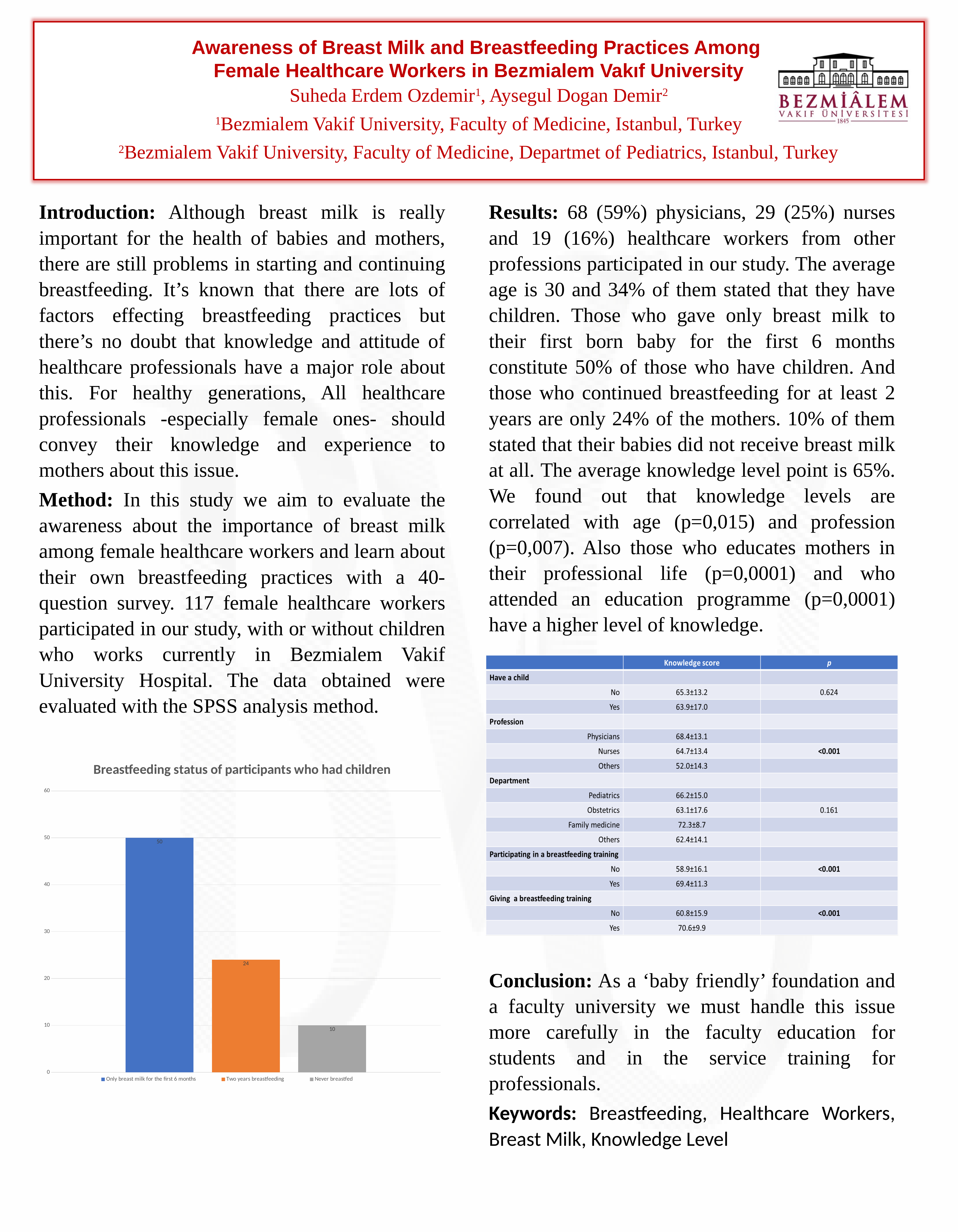
Which category has the highest value in the chart? Only breast milk for the first 6 months What is the value for 'Never breastfed' in the chart? 10 What kind of chart is shown on the slide? bar chart What is the difference between the values for 'Only breast milk for the first 6 months' and 'Two years breastfeeding'? 26 What is the value for 'Two years breastfeeding' in the chart? 24 How many bars are plotted in the chart? 3 Which category has the lowest value in the chart? Never breastfed What is the difference between the values for 'Two years breastfeeding' and 'Never breastfed'? 14 What is the title of the chart on the slide? Breastfeeding status of participants who had children Which is larger, the value for 'Two years breastfeeding' or the value for 'Never breastfed'? Two years breastfeeding What is the value for 'Only breast milk for the first 6 months' in the chart? 50 Is the value for 'Two years breastfeeding' greater or less than 30? less